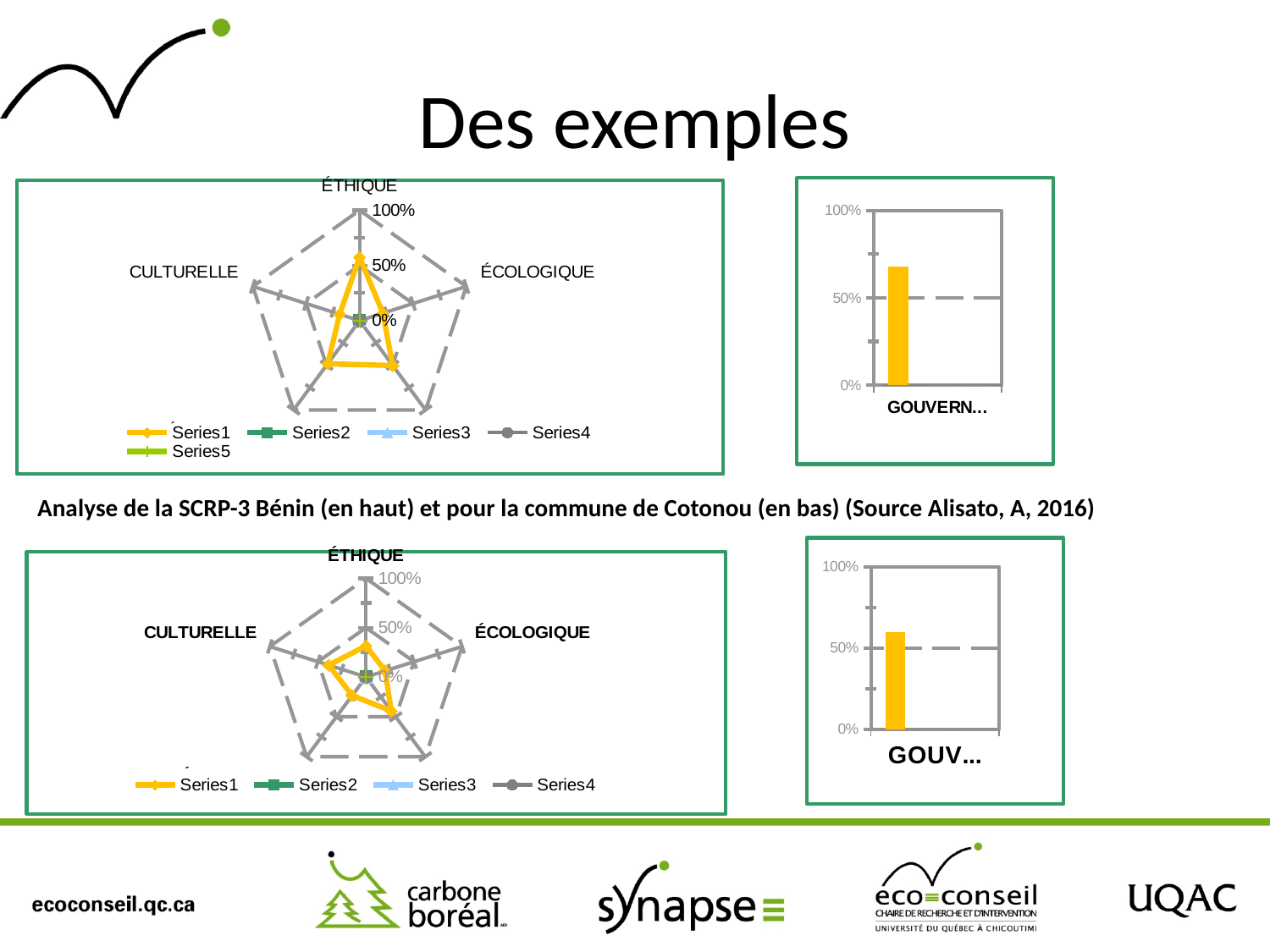
How many series does the legend of the bottom-left radar chart list? 4 In the bottom-left radar chart, is the Series1 value for ÉTHIQUE greater or less than 50%? less In the top-left radar chart, is the Series1 value for ÉTHIQUE greater or less than 50%? greater What is the highest percentage tick shown on the axis of the top-right bar chart? 100% What kind of chart is the top-left chart on the slide? radar chart How many series does the legend of the top-left radar chart list? 5 In the top-left radar chart, is the Series1 value for ÉCOLOGIQUE greater or less than 50%? less What kind of chart is the top-right chart on the slide? bar chart How many axes (spokes) does the top-left radar chart have? 5 In the top-left radar chart, which is larger for Series1: the value for ÉTHIQUE or the value for ÉCOLOGIQUE? ÉTHIQUE